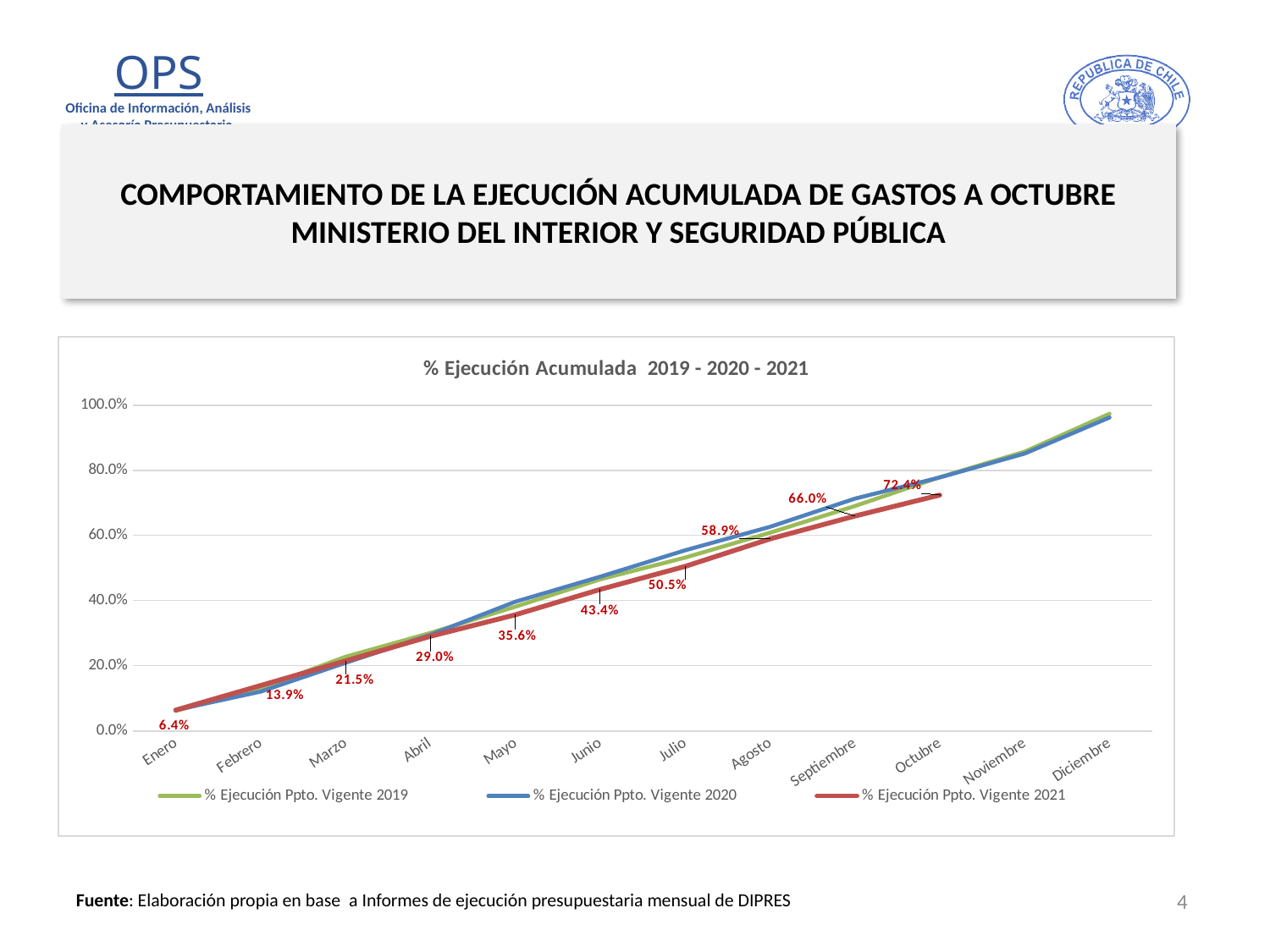
What is the difference between the % Ejecución Ppto. Vigente 2021 values for Julio and Mayo? 14.9% What is the value for % Ejecución Ppto. Vigente 2021 in Junio? 43.4% How many months are shown on the x axis? 12 How many series does the legend list? 3 In which month does the % Ejecución Ppto. Vigente 2021 series have its lowest value? Enero Is the value for % Ejecución Ppto. Vigente 2020 in Diciembre greater or less than 80.0%? greater What kind of chart is shown on the slide? Line chart What is the value for % Ejecución Ppto. Vigente 2021 in Abril? 29.0% What is the value for % Ejecución Ppto. Vigente 2021 in Octubre? 72.4% What is the difference between the % Ejecución Ppto. Vigente 2021 values for Octubre and Septiembre? 6.4% In which month does the % Ejecución Ppto. Vigente 2021 series reach its highest labelled value? Octubre What is the value for % Ejecución Ppto. Vigente 2021 in Enero? 6.4%